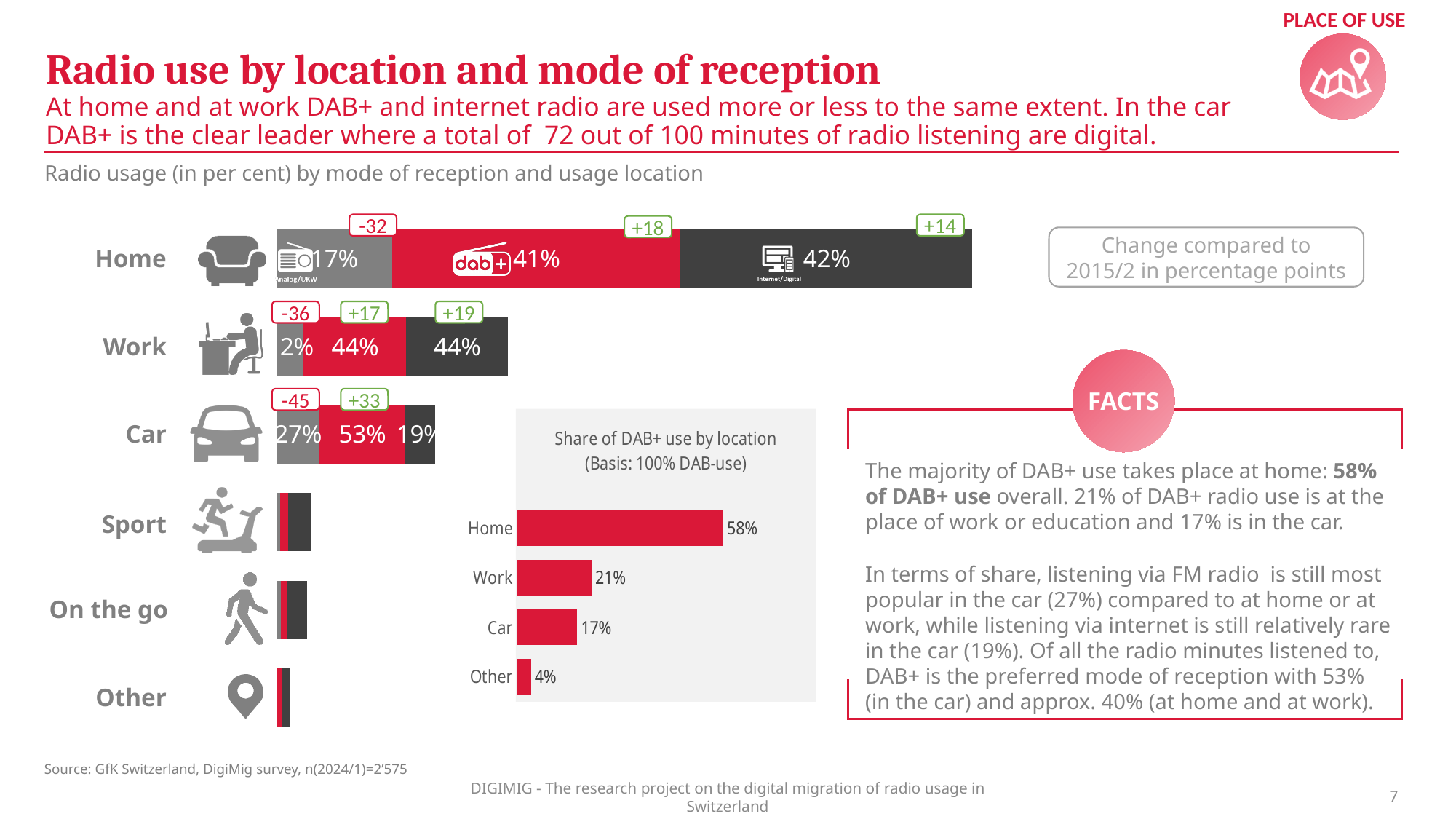
How many locations are shown in the 'Share of DAB+ use by location' chart? 4 In the 'Share of DAB+ use by location' chart, do the values rise or fall from Home down to Other? Fall In the 'Radio usage by mode of reception and usage location' chart, is the Analog/UKW share larger at home or in the car? Car In the 'Radio usage by mode of reception and usage location' chart, what is the Analog/UKW share at work? 2% In the 'Radio usage by mode of reception and usage location' chart, what is the change compared to 2015/2 in percentage points for DAB+ in the car? +33 In the 'Share of DAB+ use by location' chart, what is the value for Home? 58% In the 'Share of DAB+ use by location' chart, what is the difference between the Home and Work shares? 37 percentage points In the 'Radio usage by mode of reception and usage location' chart, what is the DAB+ share in the car? 53% What kind of chart is the 'Share of DAB+ use by location' chart? Bar chart In the 'Share of DAB+ use by location' chart, which location has the highest share? Home In the 'Radio usage by mode of reception and usage location' chart, what is the Internet/Digital share at home? 42% In the 'Share of DAB+ use by location' chart, which location has the lowest share? Other